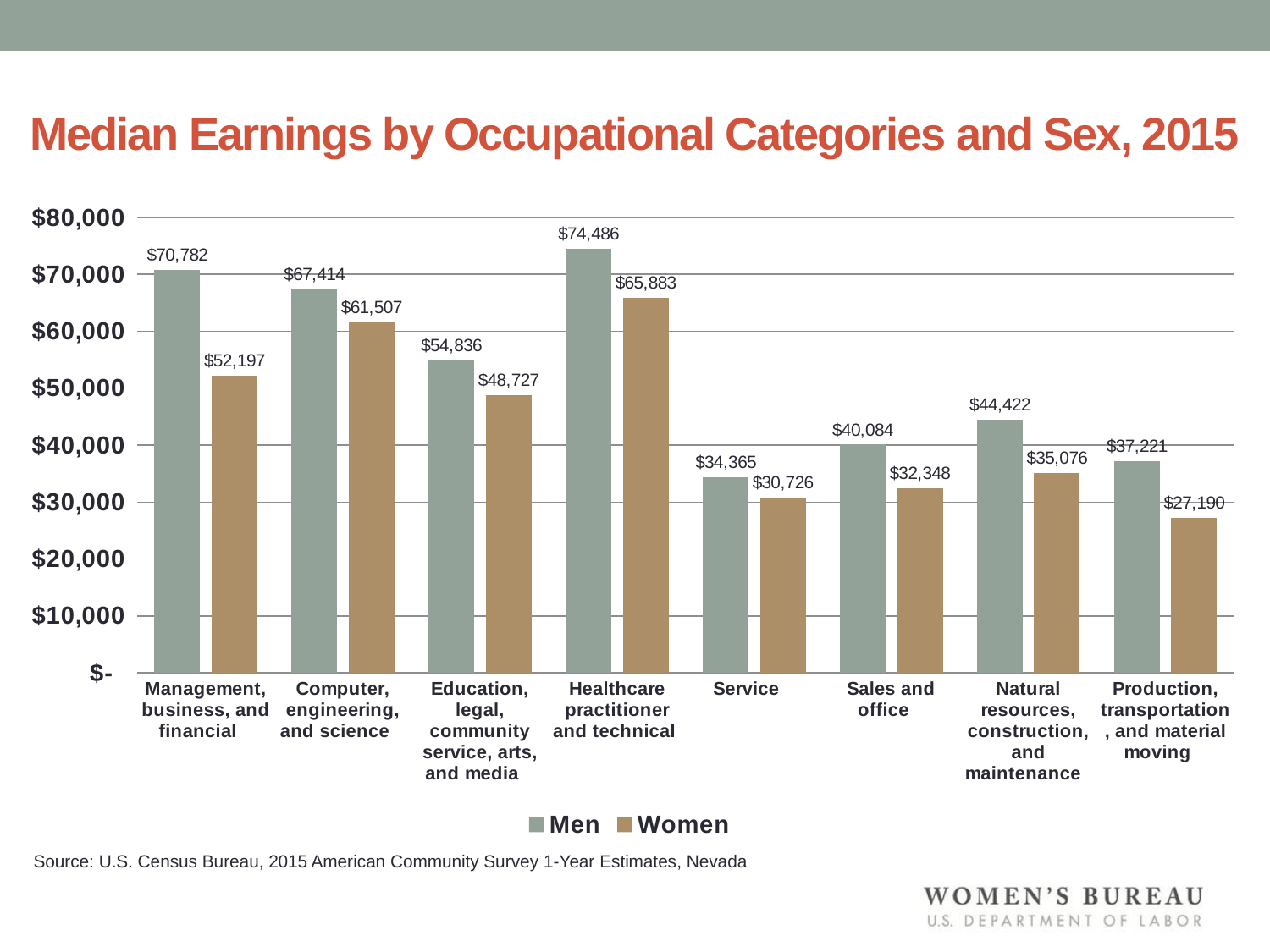
How many series does the legend list? 2 How many occupational categories are shown on the x axis? 8 What is the median earnings for men in the Healthcare practitioner and technical category? $74,486 Which is larger: women's median earnings in Education, legal, community service, arts, and media or men's median earnings in Natural resources, construction, and maintenance? Women's median earnings in Education, legal, community service, arts, and media What is the difference between men's and women's median earnings in the Management, business, and financial category? $18,585 Which occupational category has the lowest median earnings for women? Production, transportation, and material moving Which occupational category has the highest median earnings for men? Healthcare practitioner and technical What kind of chart is shown on the slide? Bar chart What is the difference between men's and women's median earnings in the Sales and office category? $7,736 What is the median earnings for women in the Service category? $30,726 What is the median earnings for women in the Computer, engineering, and science category? $61,507 What is the title of the chart? Median Earnings by Occupational Categories and Sex, 2015